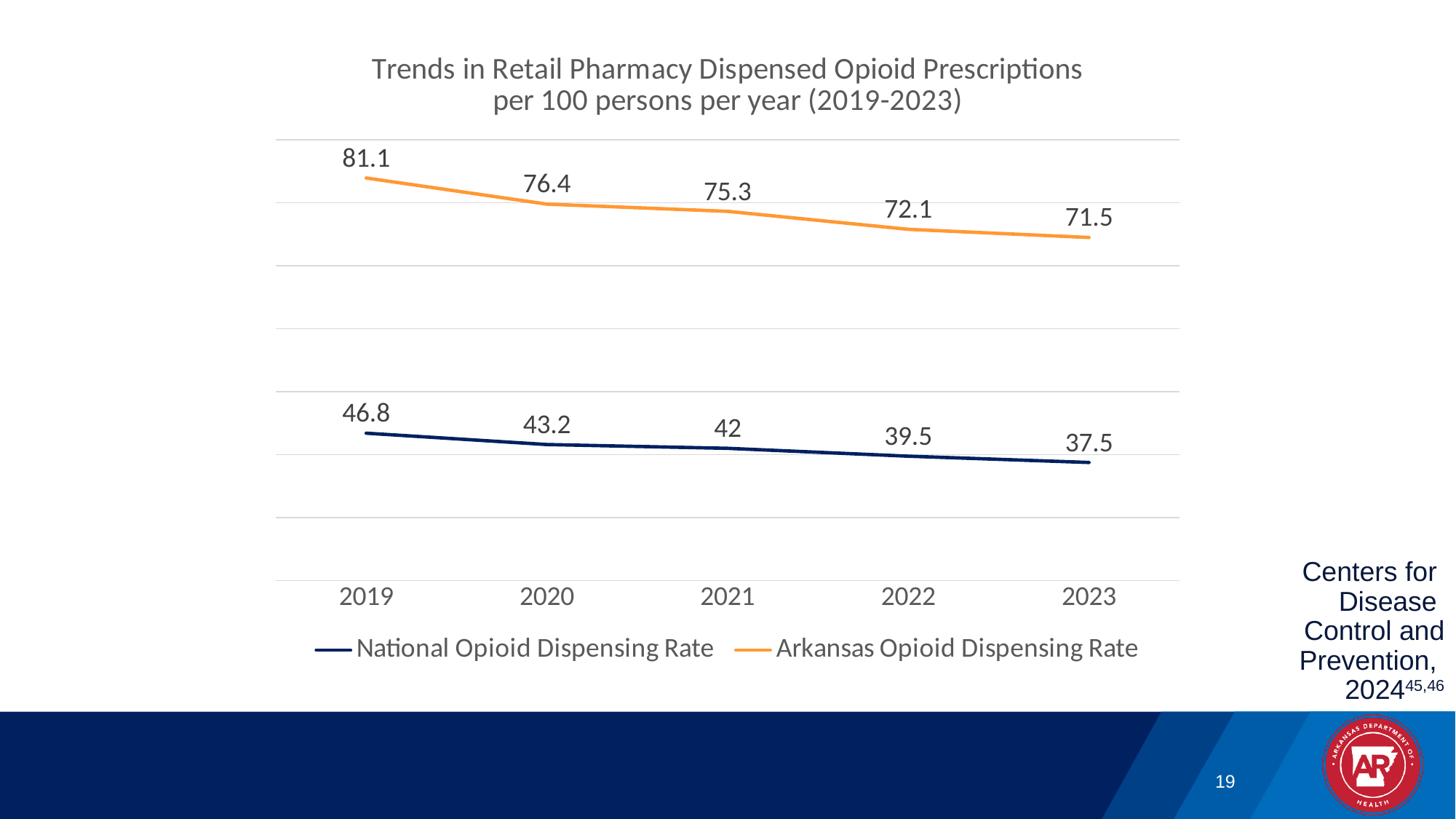
What was the Arkansas Opioid Dispensing Rate in 2019? 81.1 What kind of chart is shown on the slide? Line chart What is the difference between the Arkansas and National Opioid Dispensing Rates in 2022? 32.6 By how much did the National Opioid Dispensing Rate fall from 2019 to 2023? 9.3 What was the Arkansas Opioid Dispensing Rate in 2023? 71.5 In which year was the Arkansas Opioid Dispensing Rate highest? 2019 What was the National Opioid Dispensing Rate in 2021? 42 In which year was the National Opioid Dispensing Rate lowest? 2023 Does the Arkansas Opioid Dispensing Rate rise or fall from 2019 to 2023? Fall Which was higher in 2020, the National Opioid Dispensing Rate or the Arkansas Opioid Dispensing Rate? Arkansas Opioid Dispensing Rate How many series does the legend list? 2 How many years are shown on the x axis? 5